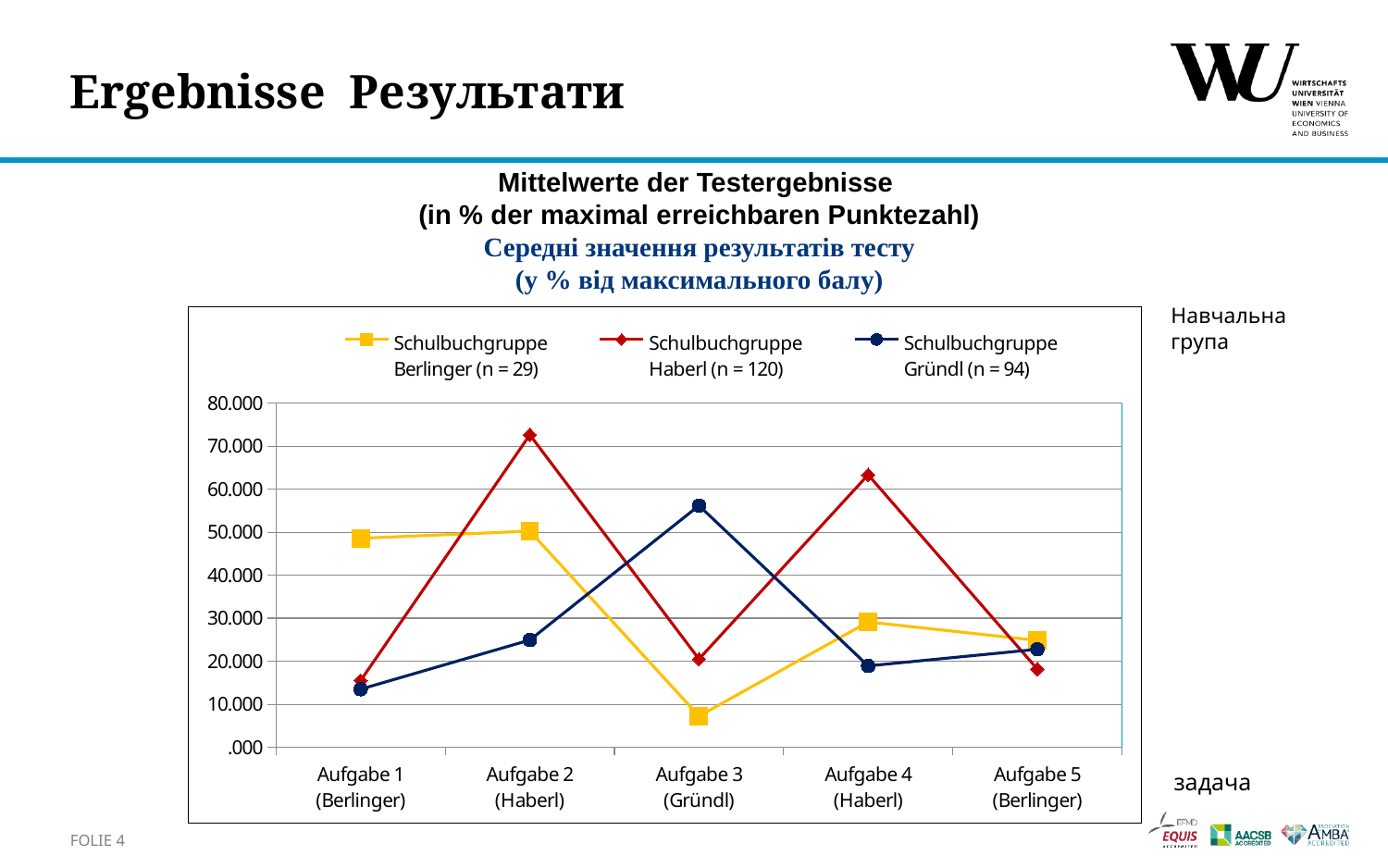
At which Aufgabe does Schulbuchgruppe Haberl reach its highest value? Aufgabe 2 (Haberl) Does the value for Schulbuchgruppe Berlinger rise or fall from Aufgabe 2 to Aufgabe 3? fall What kind of chart is shown on the slide? line chart Is the value for Schulbuchgruppe Gründl at Aufgabe 3 greater or less than 50.000? greater How many series does the legend list? 3 At Aufgabe 4, which group has the higher value: Schulbuchgruppe Haberl or Schulbuchgruppe Berlinger? Schulbuchgruppe Haberl At which Aufgabe does Schulbuchgruppe Gründl reach its highest value? Aufgabe 3 (Gründl) At which Aufgabe does Schulbuchgruppe Berlinger have its lowest value? Aufgabe 3 (Gründl) Is the value for Schulbuchgruppe Berlinger at Aufgabe 3 greater or less than 10.000? less Is the value for Schulbuchgruppe Haberl at Aufgabe 2 greater or less than 70.000? greater According to the legend, what is the sample size (n) of Schulbuchgruppe Haberl? n = 120 How many Aufgabe categories are shown on the x axis? 5